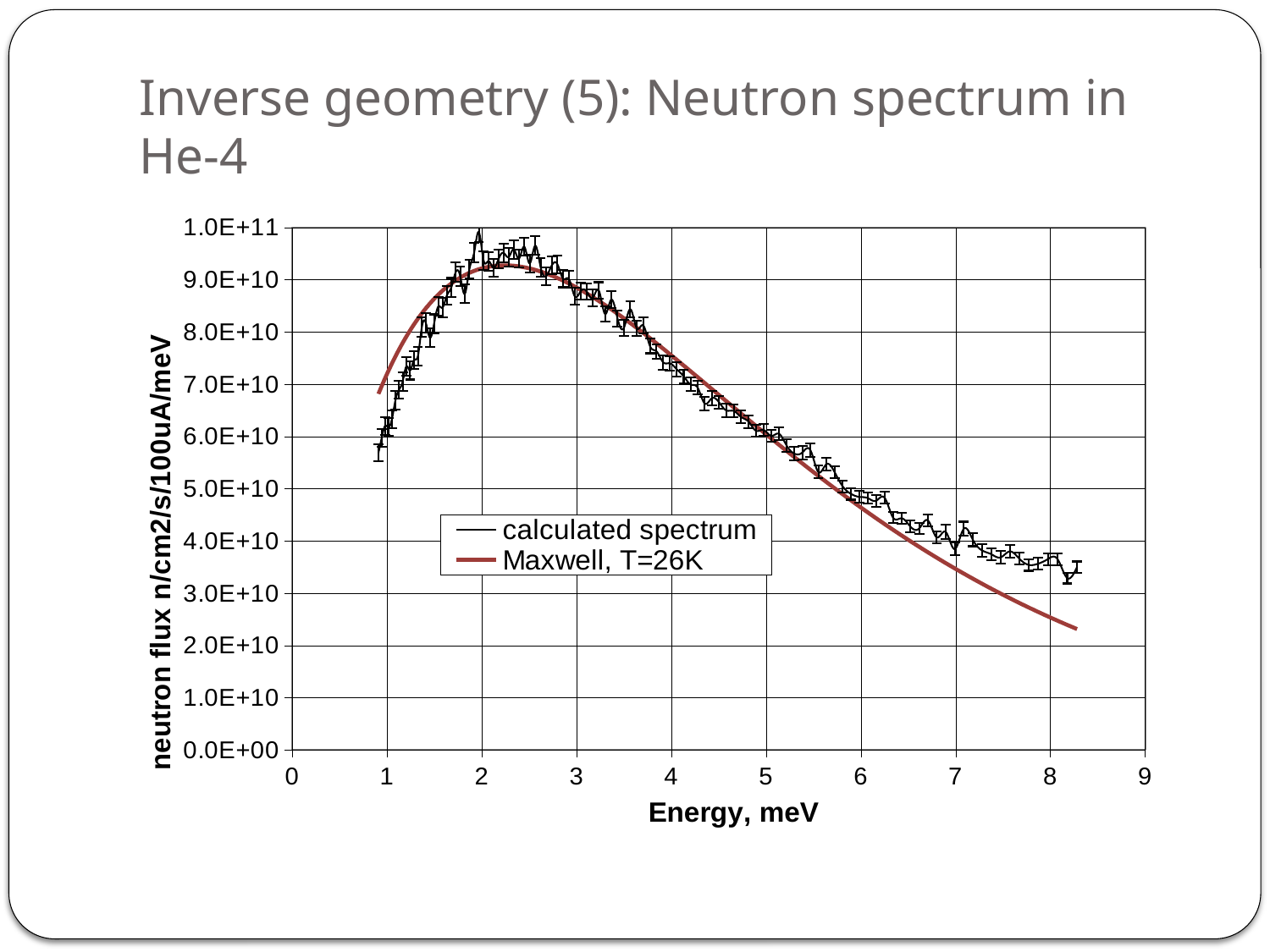
What kind of chart is shown on the slide? line chart Is the value of the calculated spectrum at an energy of 8 meV greater or less than 3.0E+10? greater What are the two series named in the legend? calculated spectrum; Maxwell, T=26K Is the value of the Maxwell, T=26K curve at an energy of 4 meV greater or less than 8.0E+10? less What is the x-axis title of the chart? Energy, meV Is the value of the Maxwell, T=26K curve at an energy of 8 meV greater or less than 3.0E+10? less How many series does the legend list? 2 At an energy of 1 meV, which series has the higher value: the calculated spectrum or the Maxwell, T=26K curve? Maxwell, T=26K At an energy of 8 meV, which series has the higher value: the calculated spectrum or the Maxwell, T=26K curve? calculated spectrum Between energies of 4 meV and 8 meV, does the calculated spectrum rise or fall as energy increases? fall